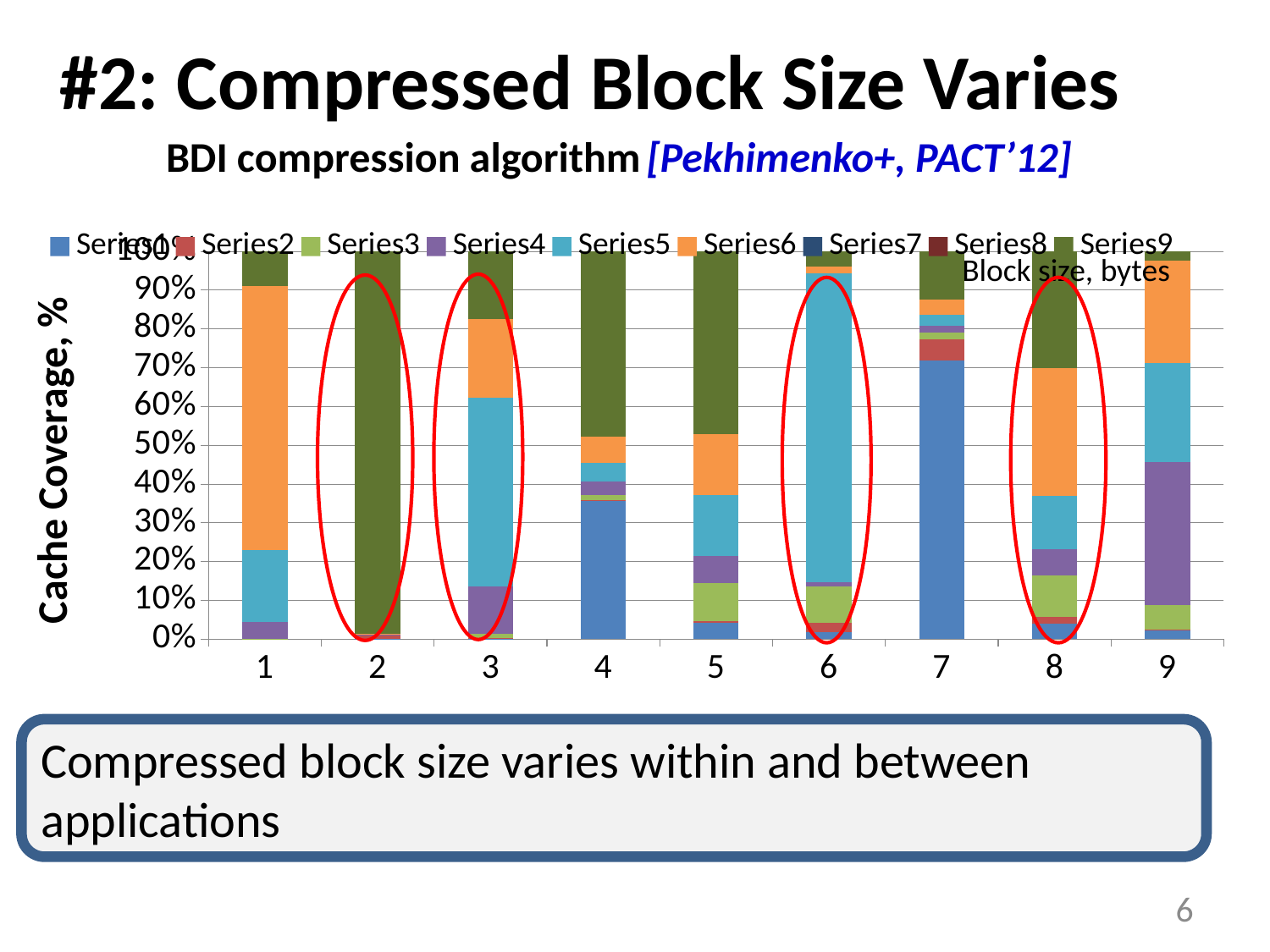
Is the Series1 segment for category 7 greater or less than 50%? greater What is the name of the last series listed in the chart legend? Series9 How many series does the chart legend list? 9 Which category has the largest Series1 segment? 7 What kind of chart is shown on the slide? stacked bar chart Which category has the largest Series9 segment? 2 Is the Series1 segment for category 4 greater or less than 40%? less Is the Series9 segment for category 2 greater or less than 90%? greater Is the Series1 segment larger for category 7 or for category 4? 7 What is the title of the y axis of the chart? Cache Coverage, % How many categories are shown along the x axis of the chart? 9